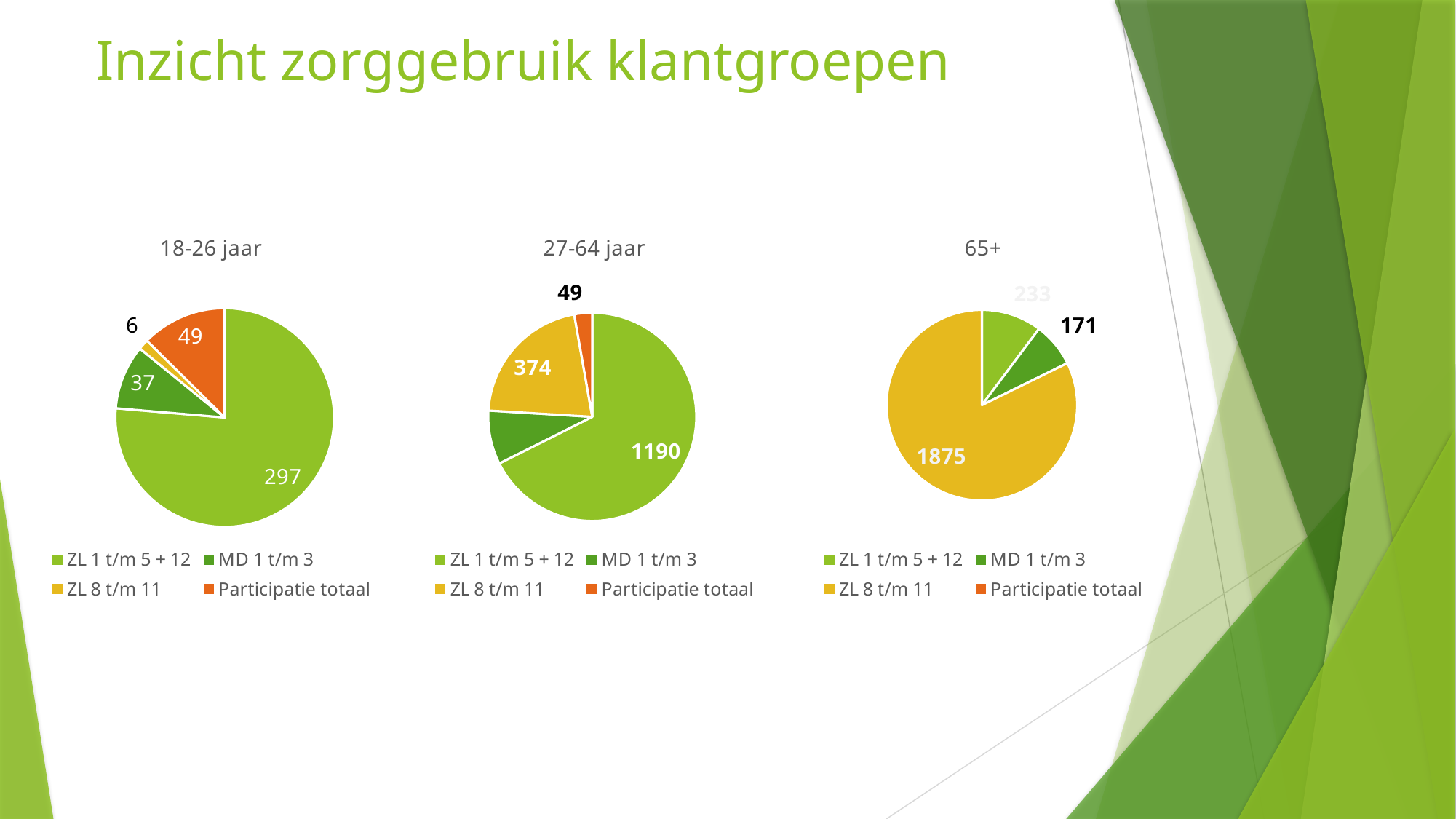
In the 65+ chart, which category has the largest slice? ZL 8 t/m 11 In the 65+ chart, what is the value for ZL 8 t/m 11? 1875 What type of chart is used for the 27-64 jaar data? Pie chart In the 18-26 jaar chart, which category has the smallest slice? ZL 8 t/m 11 In the 18-26 jaar chart, what is the value for Participatie totaal? 49 In the 18-26 jaar chart, what is the value for MD 1 t/m 3? 37 In the 65+ chart, what is the value for MD 1 t/m 3? 171 In the 18-26 jaar chart, what is the value for ZL 1 t/m 5 + 12? 297 In the 27-64 jaar chart, what is the value for ZL 8 t/m 11? 374 In the 27-64 jaar chart, what is the value for ZL 1 t/m 5 + 12? 1190 In the 27-64 jaar chart, what is the difference between ZL 1 t/m 5 + 12 and ZL 8 t/m 11? 816 In the 18-26 jaar chart, what is the difference between ZL 1 t/m 5 + 12 and Participatie totaal? 248